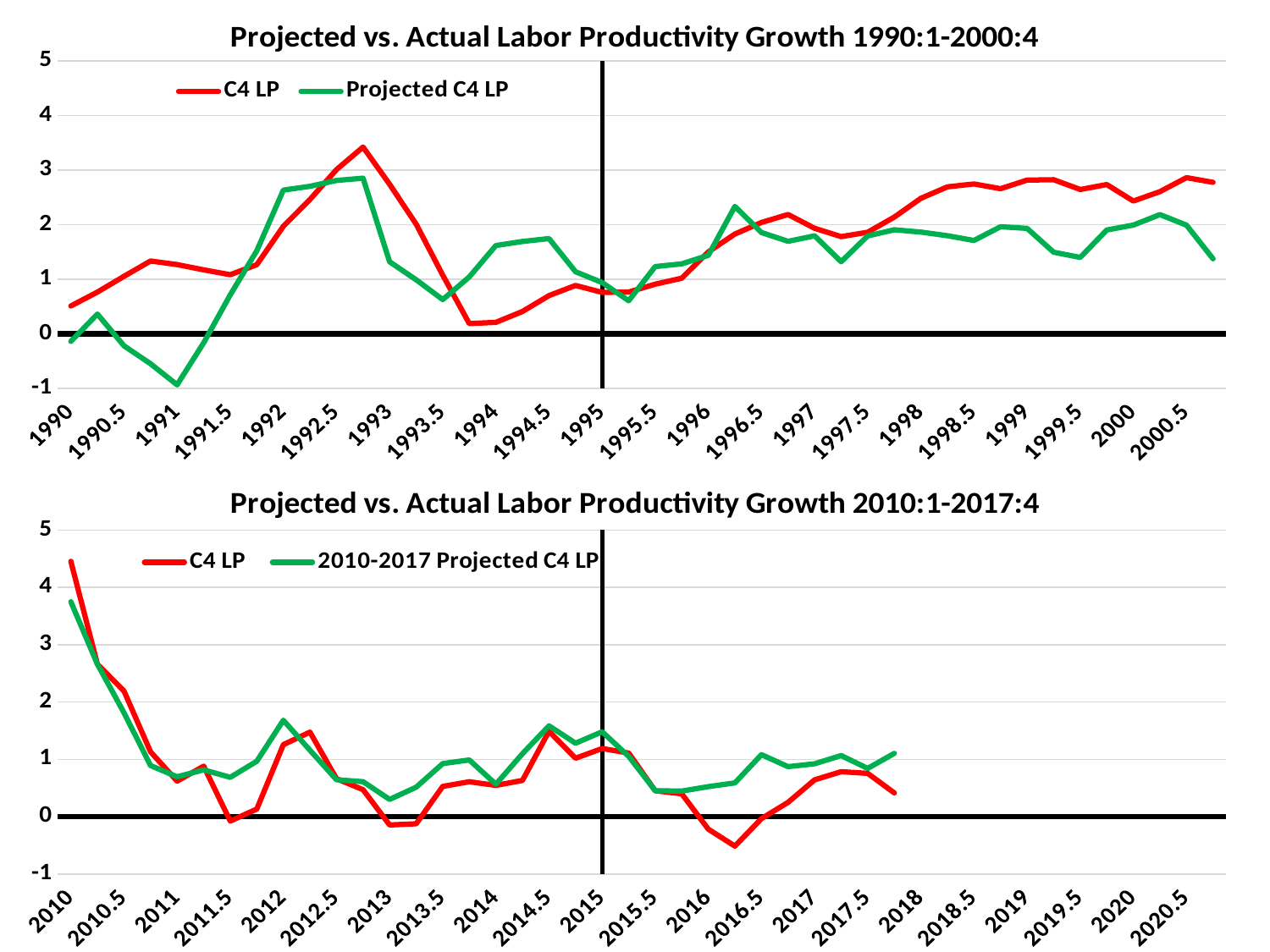
What kind of chart is the top chart, 'Projected vs. Actual Labor Productivity Growth 1990:1-2000:4'? Line chart In the bottom chart, what is the name of the green series in the legend? 2010-2017 Projected C4 LP In the top chart, which series reaches the highest value anywhere on the chart? C4 LP What is the title of the top chart? Projected vs. Actual Labor Productivity Growth 1990:1-2000:4 In the top chart, is the value of Projected C4 LP at 1991 greater or less than 0? less In the bottom chart, at 2016.5, which series has the larger value, C4 LP or 2010-2017 Projected C4 LP? 2010-2017 Projected C4 LP In the bottom chart, is the value of C4 LP at 2010 greater or less than 4? greater In the bottom chart, does the C4 LP series rise or fall from 2010 to 2011? Fall How many series does the legend of the bottom chart, 'Projected vs. Actual Labor Productivity Growth 2010:1-2017:4', list? 2 In the top chart, at 1993, which series has the larger value, C4 LP or Projected C4 LP? C4 LP